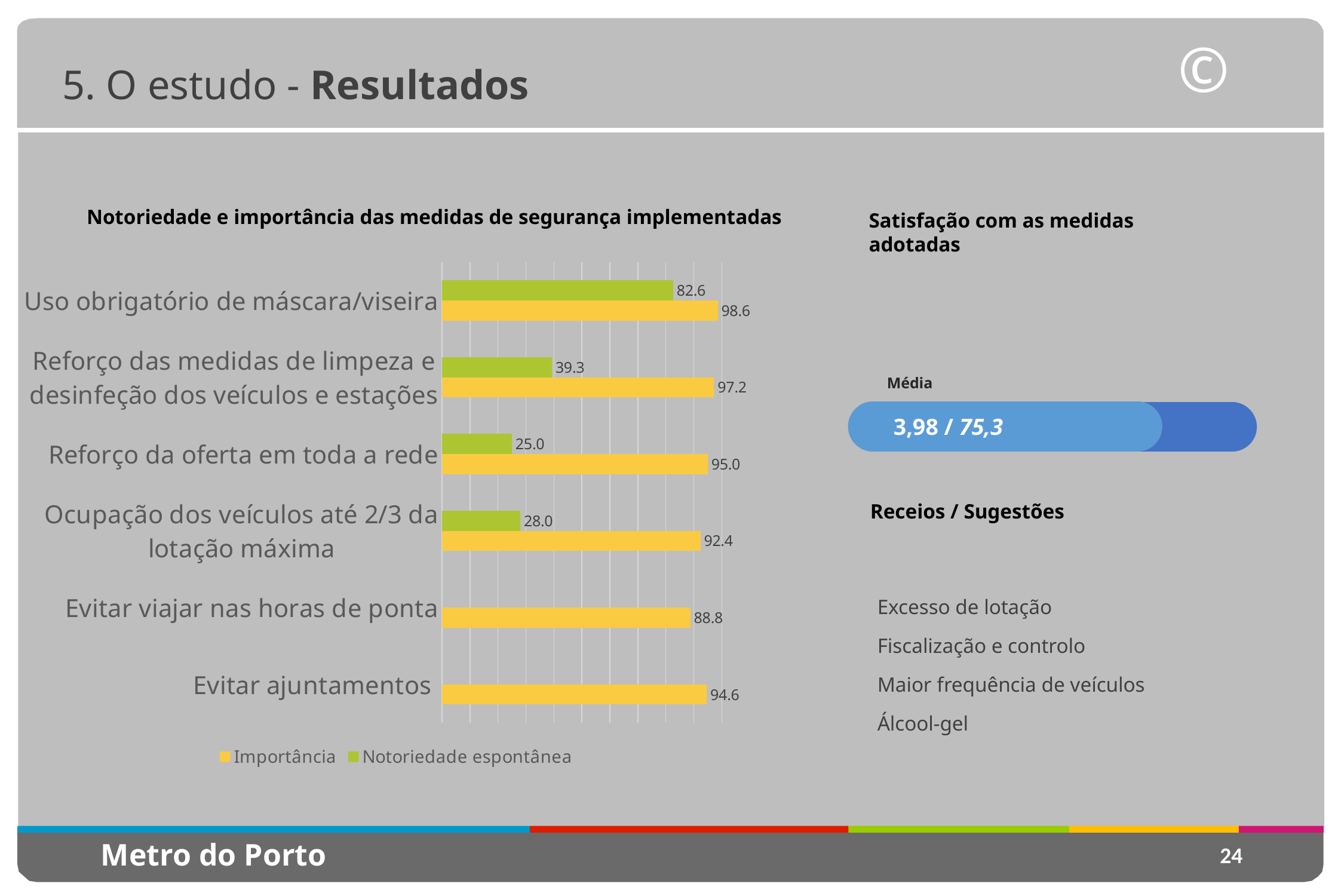
What is the Notoriedade espontânea value for "Reforço das medidas de limpeza e desinfeção dos veículos e estações"? 39.3 What is the Importância value for "Uso obrigatório de máscara/viseira"? 98.6 What is the title of the chart? Notoriedade e importância das medidas de segurança implementadas Which category has the highest Importância value? Uso obrigatório de máscara/viseira What is the Importância value for "Evitar viajar nas horas de ponta"? 88.8 Which is larger: the Notoriedade espontânea value for "Ocupação dos veículos até 2/3 da lotação máxima" or for "Reforço da oferta em toda a rede"? Ocupação dos veículos até 2/3 da lotação máxima Which category has the lowest Notoriedade espontânea value among those with a green bar? Reforço da oferta em toda a rede How many series does the chart legend list? 2 How many categories are shown on the chart? 6 What is the difference between the Importância and Notoriedade espontânea values for "Uso obrigatório de máscara/viseira"? 16.0 Which category has the lowest Importância value? Evitar viajar nas horas de ponta What type of chart is shown on the slide? bar chart